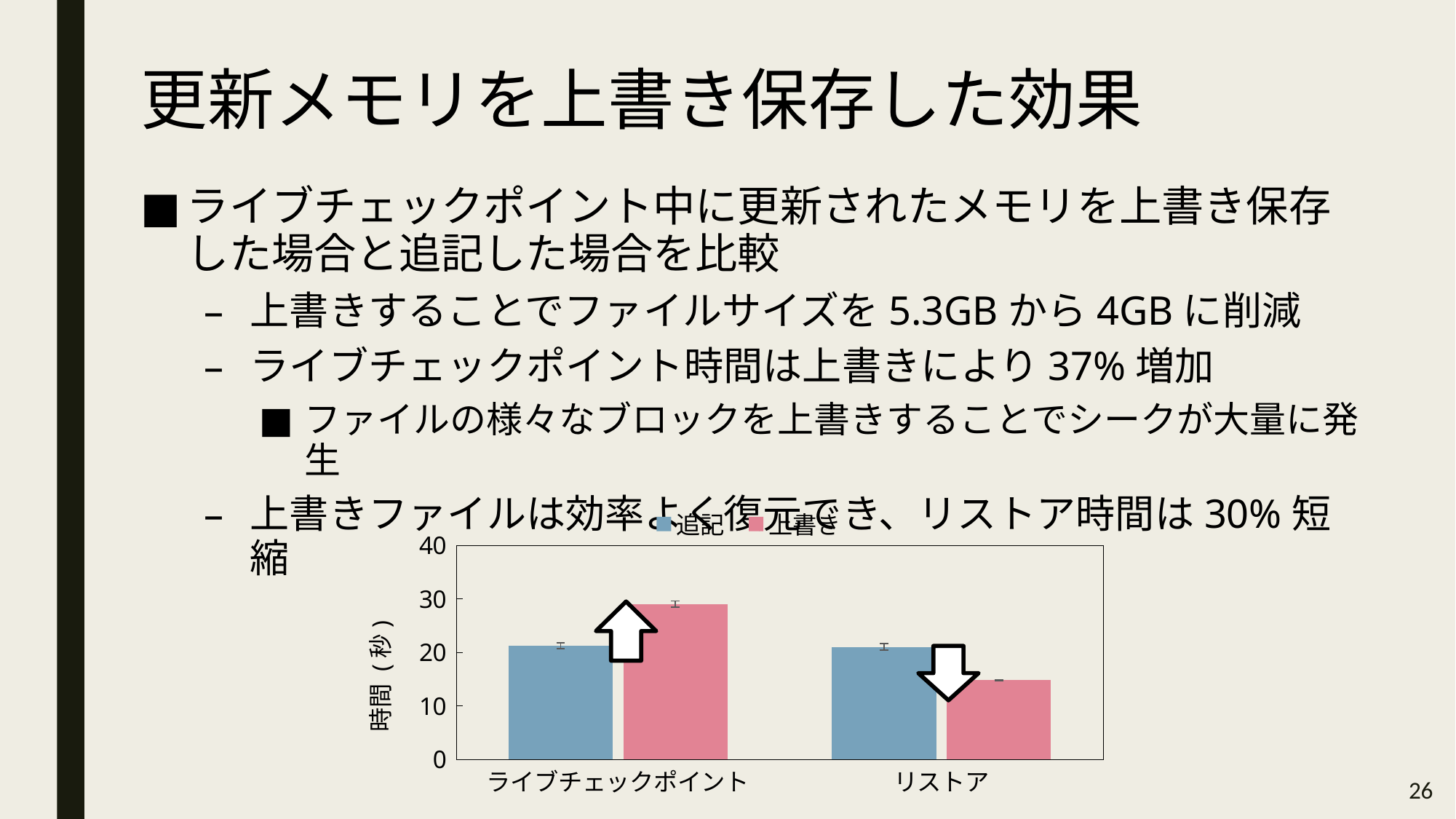
Is the 上書き value for リストア greater or less than 20? less For ライブチェックポイント, which series has the larger value, 追記 or 上書き? 上書き How many series does the chart's legend list? 2 Is the 上書き value for ライブチェックポイント greater or less than 20? greater Which bar in the chart is the shortest? 上書き for リストア Is the 追記 value for ライブチェックポイント greater or less than 30? less What kind of chart is shown on the slide? bar chart What are the two series listed in the chart's legend? 追記 and 上書き Which bar in the chart is the tallest? 上書き for ライブチェックポイント For リストア, which series has the larger value, 追記 or 上書き? 追記 What is the label of the chart's y axis? 時間（秒） How many categories are shown on the x axis of the chart? 2